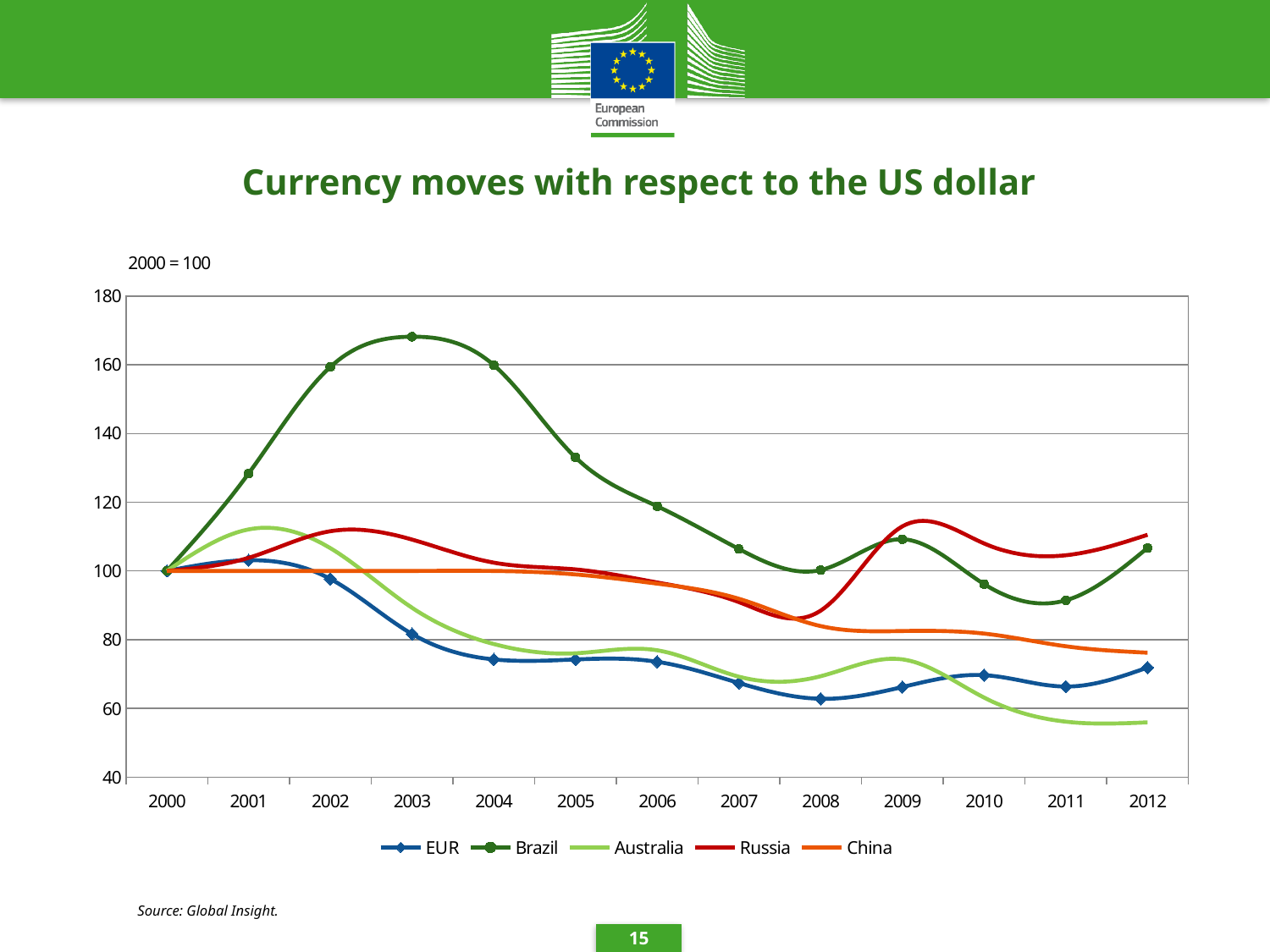
Is the value for Brazil in 2003 greater or less than 160? greater In 2012, which is higher: Russia or China? Russia Is the value for EUR in 2008 greater or less than 80? less Which currency has the highest index value in 2003? Brazil Which currency has the lowest index value in 2012? Australia What is the title of the chart? Currency moves with respect to the US dollar How many series does the legend list? 5 Does the Australia line rise or fall from 2009 to 2012? fall How many years are shown along the x axis? 13 Is the value for Australia in 2012 greater or less than 60? less What is the index value of all currencies in 2000? 100 What kind of chart is shown on the slide? line chart